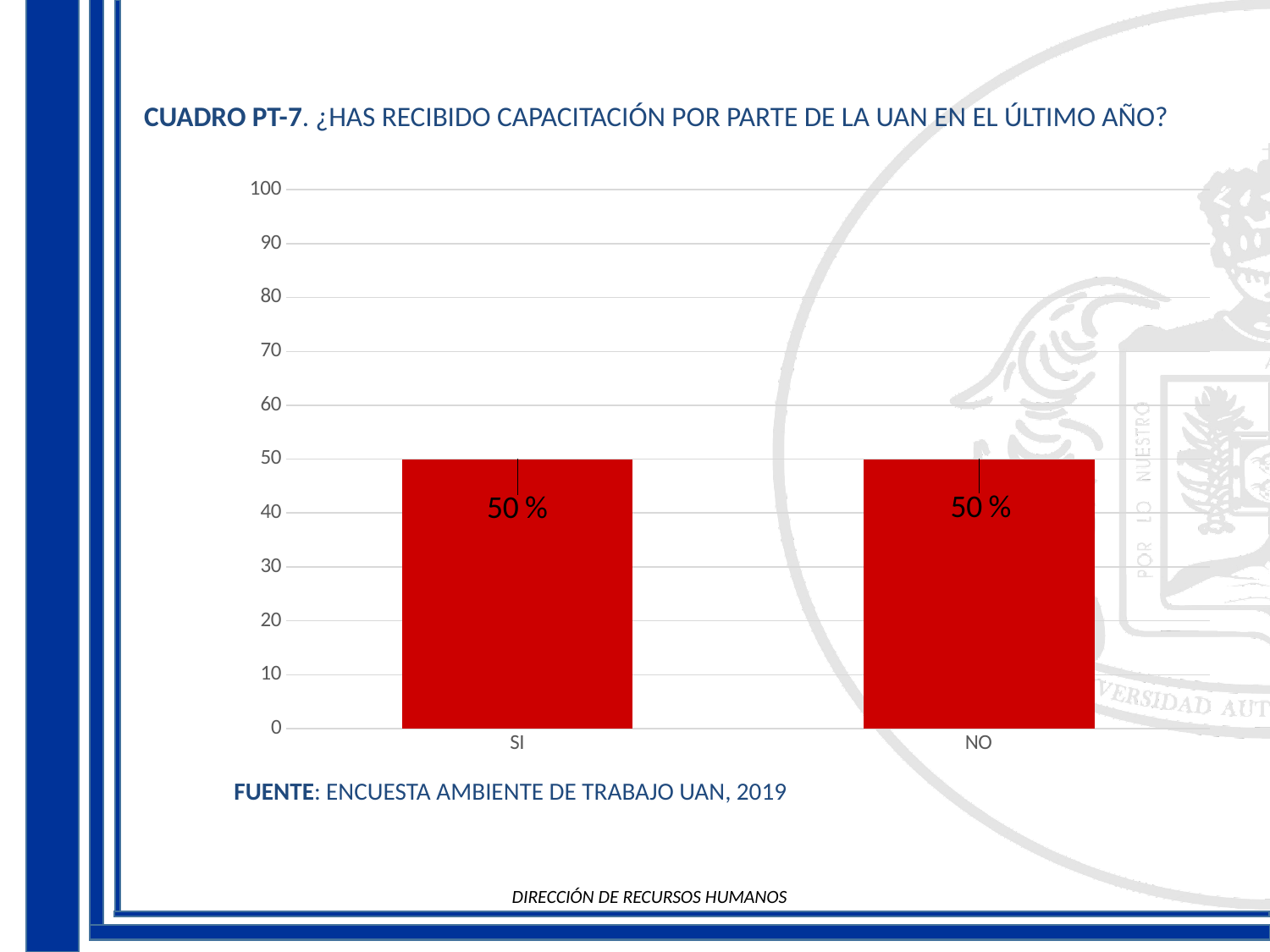
What is the value for NO? 50 % What is the value for SI? 50 % How many categories are shown on the x axis? 2 What kind of chart is shown on the slide? bar chart Do the values for SI and NO differ, or are they equal? equal What is the difference between the values for SI and NO? 0 Is the value for NO greater or less than 40? greater What is the highest value shown on the vertical axis? 100 Is the value for SI greater or less than 60? less What colour are the bars in the chart? red